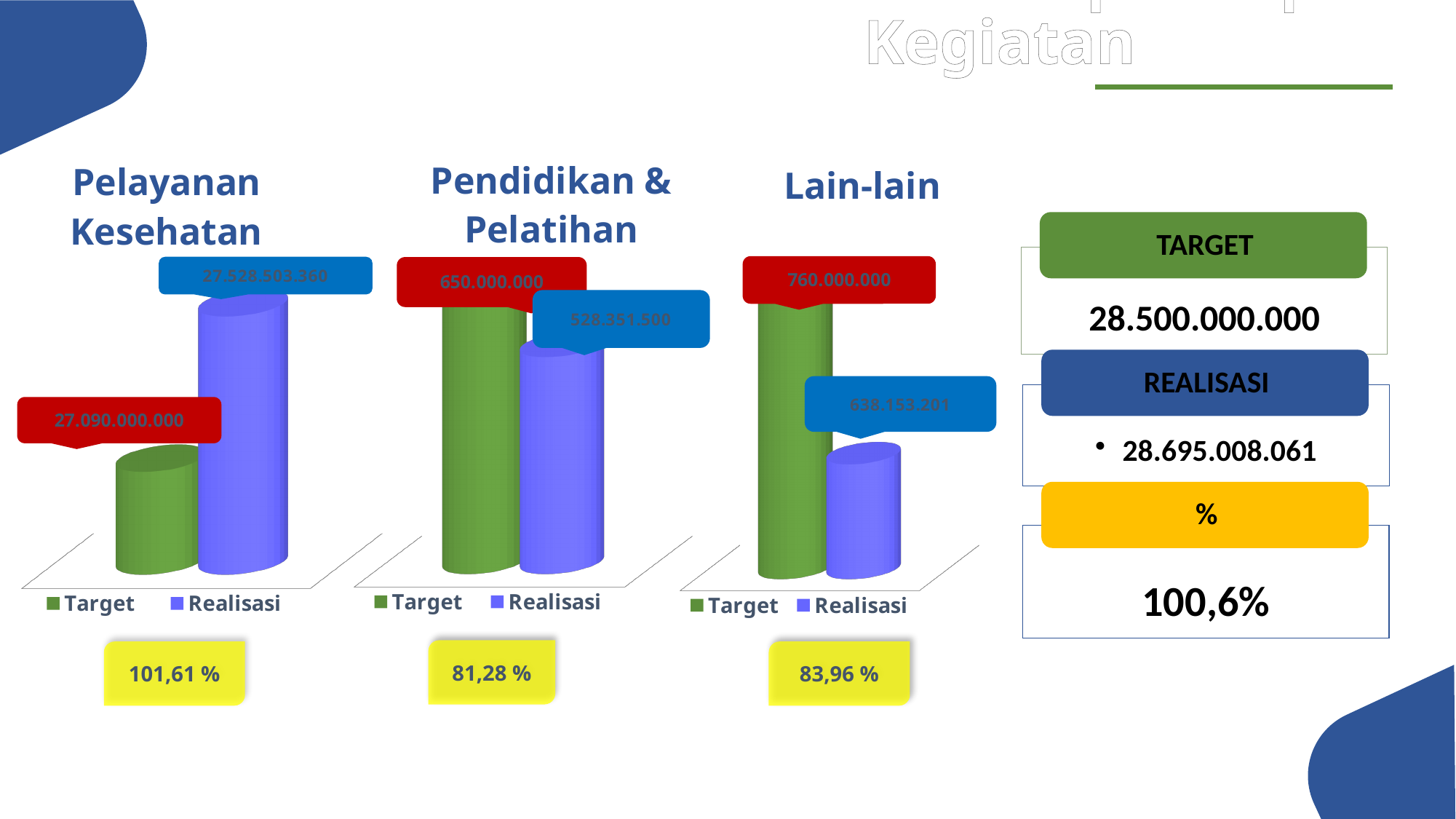
In the Pelayanan Kesehatan chart, what is the difference between Realisasi and Target? 438.503.360 In the Lain-lain chart, what is the difference between Target and Realisasi? 121.846.799 In the Pendidikan & Pelatihan chart, what is the value for Realisasi? 528.351.500 In the Pendidikan & Pelatihan chart, what is the value for Target? 650.000.000 In the Lain-lain chart, which is larger, Target or Realisasi? Target In the Pendidikan & Pelatihan chart, what is the difference between Target and Realisasi? 121.648.500 In the Pelayanan Kesehatan chart, what is the value for Target? 27.090.000.000 How many series does the legend of the Lain-lain chart list? 2 In the Pelayanan Kesehatan chart, which is larger, Target or Realisasi? Realisasi What kind of chart is the Pendidikan & Pelatihan chart? Bar chart In the Pelayanan Kesehatan chart, what is the value for Realisasi? 27.528.503.360 In the Lain-lain chart, what is the value for Realisasi? 638.153.201